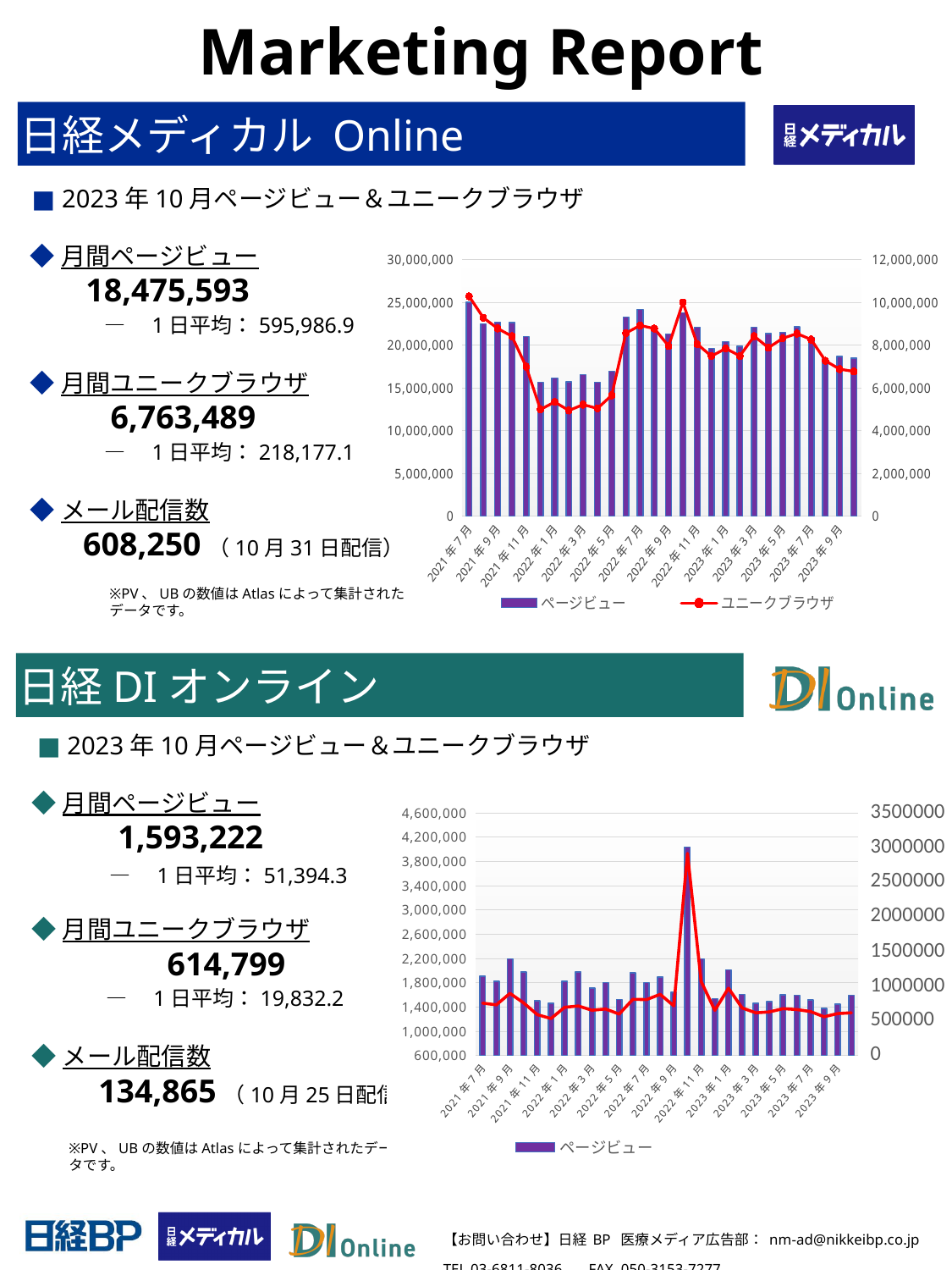
In the 日経DIオンライン chart, which month has the highest ページビュー value? 2022年10月 In the 日経メディカル Online chart, which has the larger ページビュー value, 2021年7月 or 2022年1月? 2021年7月 How many series does the legend of the 日経メディカル Online chart list? 2 In the 日経メディカル Online chart, is the ページビュー value for 2022年1月 greater or less than 20,000,000? less In the 日経メディカル Online chart, is the ページビュー value for 2021年7月 greater or less than 20,000,000? greater In the 日経DIオンライン chart, which has the larger ページビュー value, 2022年9月 or 2022年11月? 2022年11月 In the 日経DIオンライン chart, is the ページビュー value for 2022年11月 greater or less than 3,400,000? less What is the highest tick value on the left axis of the 日経メディカル Online chart? 30,000,000 What kind of chart is shown in the 日経メディカル Online section? bar chart with a line How many series does the legend of the 日経DIオンライン chart list? 1 In the 日経メディカル Online chart, do the ページビュー values rise or fall from 2021年7月 to 2022年1月? fall